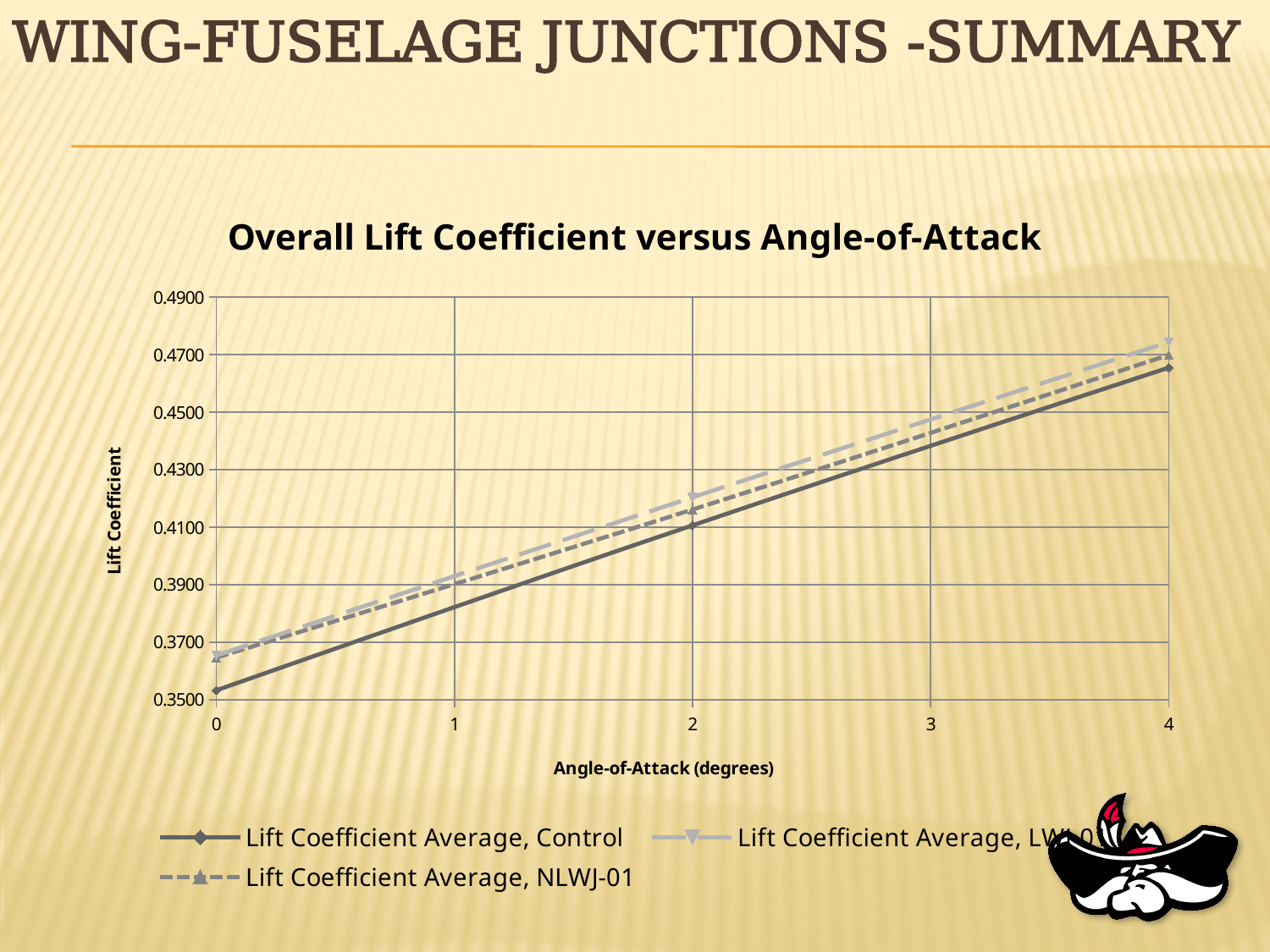
Does the lift coefficient for the Control series rise or fall as the angle of attack increases? rise Does the lift coefficient for the NLWJ-01 series rise or fall as the angle of attack increases? rise What kind of chart is shown on the slide? line chart Is the value for the Control series at an angle of attack of 2 degrees greater or less than 0.4300? less What is the title of the chart? Overall Lift Coefficient versus Angle-of-Attack Which series has the lowest lift coefficient at an angle of attack of 0 degrees? Lift Coefficient Average, Control Is the value for the Control series at an angle of attack of 4 degrees greater or less than 0.4500? greater Is the value for the NLWJ-01 series at an angle of attack of 2 degrees greater or less than 0.4100? greater How many series does the chart legend list? 3 What is the label of the x axis? Angle-of-Attack (degrees) At an angle of attack of 0 degrees, which is larger: the Control series or the NLWJ-01 series? NLWJ-01